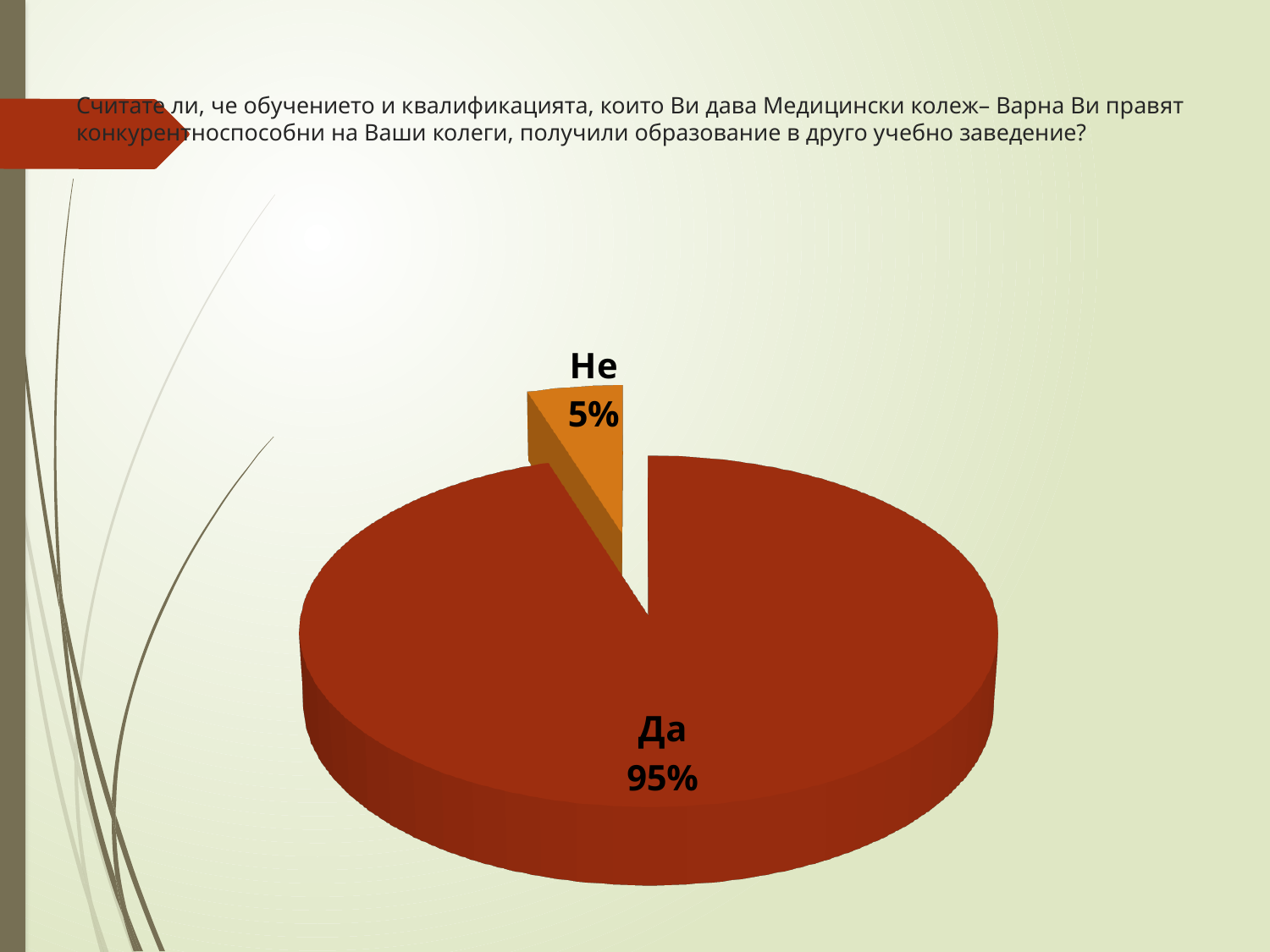
What percentage of respondents answered "Да"? 95% What colour is the "Не" slice? orange What share of the pie does the "Не" slice represent? 5% What colour is the "Да" slice? dark red How many slices does the pie chart have? 2 What kind of chart is shown on the slide? pie chart Which answer has the largest share of the pie? Да Which slice is larger, "Да" or "Не"? Да What percentage of respondents answered "Не"? 5% What is the difference in percentage points between the "Да" and "Не" slices? 90 Which answer has the smallest share of the pie? Не